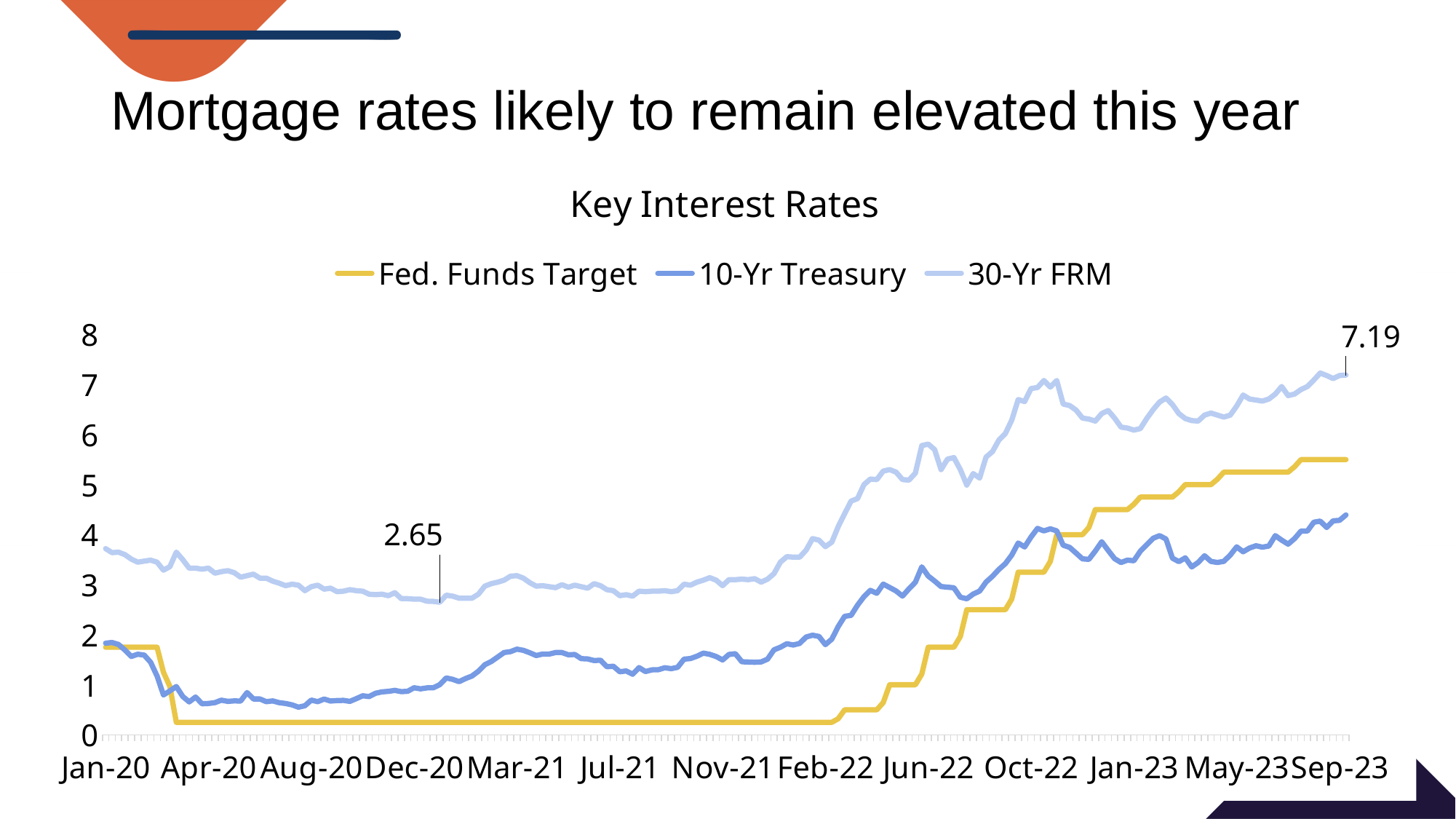
What kind of chart is shown on the slide? line chart At Sep-23, which is higher: the Fed. Funds Target or the 10-Yr Treasury? Fed. Funds Target Is the value of the 30-Yr FRM at Jan-20 greater or less than 3? greater What is the data label shown at the end of the 30-Yr FRM line at Sep-23? 7.19 Is the value of the Fed. Funds Target at Jul-21 greater or less than 1? less Is the value of the Fed. Funds Target at Sep-23 greater or less than 5? greater How many series does the legend of the Key Interest Rates chart list? 3 What is the difference between the two labeled 30-Yr FRM values, 7.19 and 2.65? 4.54 What is the data label shown on the 30-Yr FRM line near Dec-20? 2.65 What is the title of the chart? Key Interest Rates Does the Fed. Funds Target line rise or fall between Feb-22 and Sep-23? rise